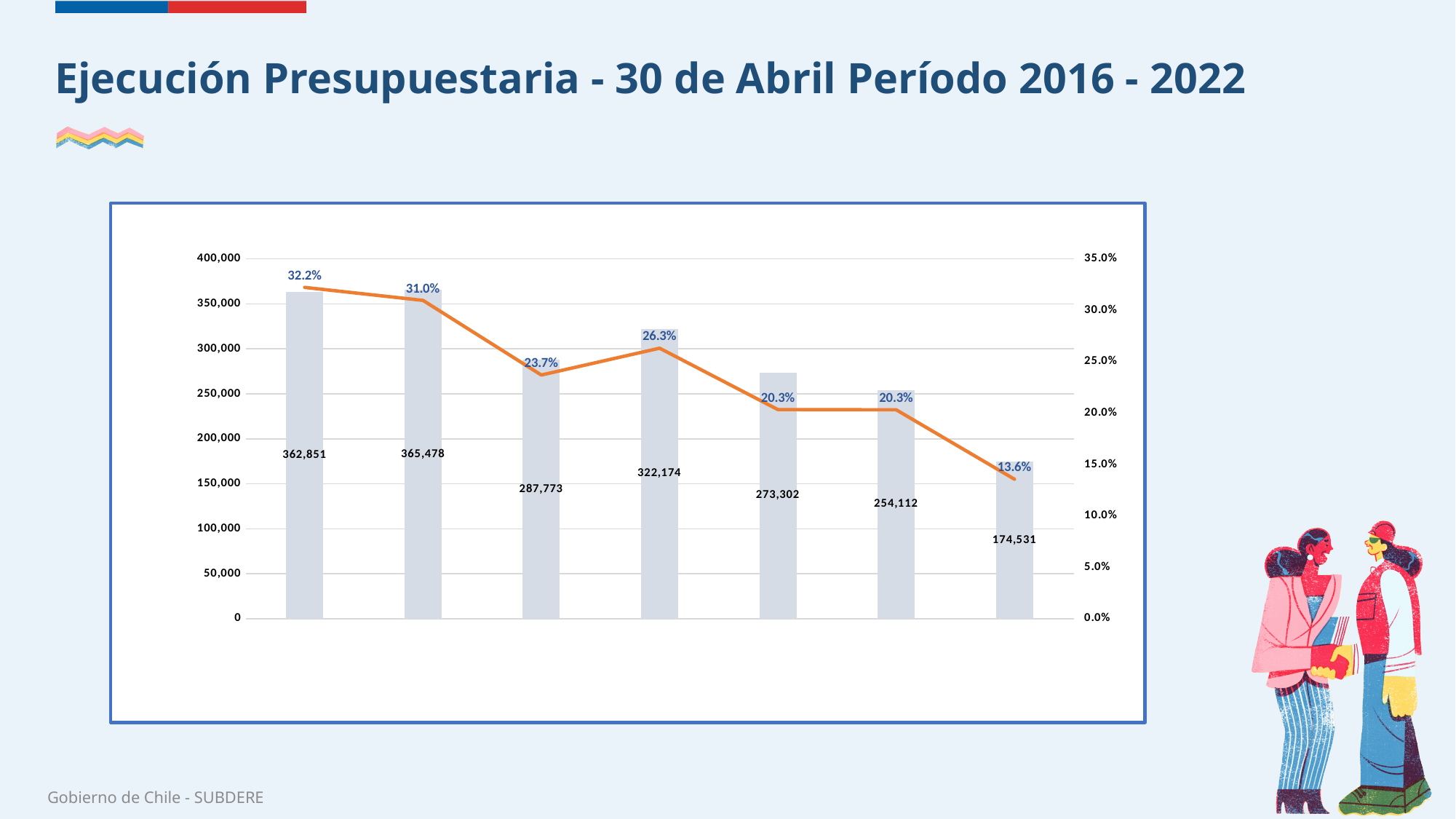
How many bars are plotted in the chart? 7 Do the percentage values on the line generally rise or fall from left to right? Fall What is the data label on the last (rightmost) bar? 174,531 What percentage is shown on the line above the fourth bar? 26.3% What is the difference between the second bar (365,478) and the first bar (362,851)? 2,627 What is the difference between the sixth bar (254,112) and the seventh bar (174,531)? 79,581 What kind of chart is shown on the slide? A combined bar and line chart What is the data label on the first (leftmost) bar? 362,851 Which bar has the highest value, and what is it? The second bar, 365,478 What is the lowest percentage shown on the line? 13.6% What percentage is shown on the line above the third bar? 23.7% Which is larger, the third bar or the fourth bar? The fourth bar (322,174)